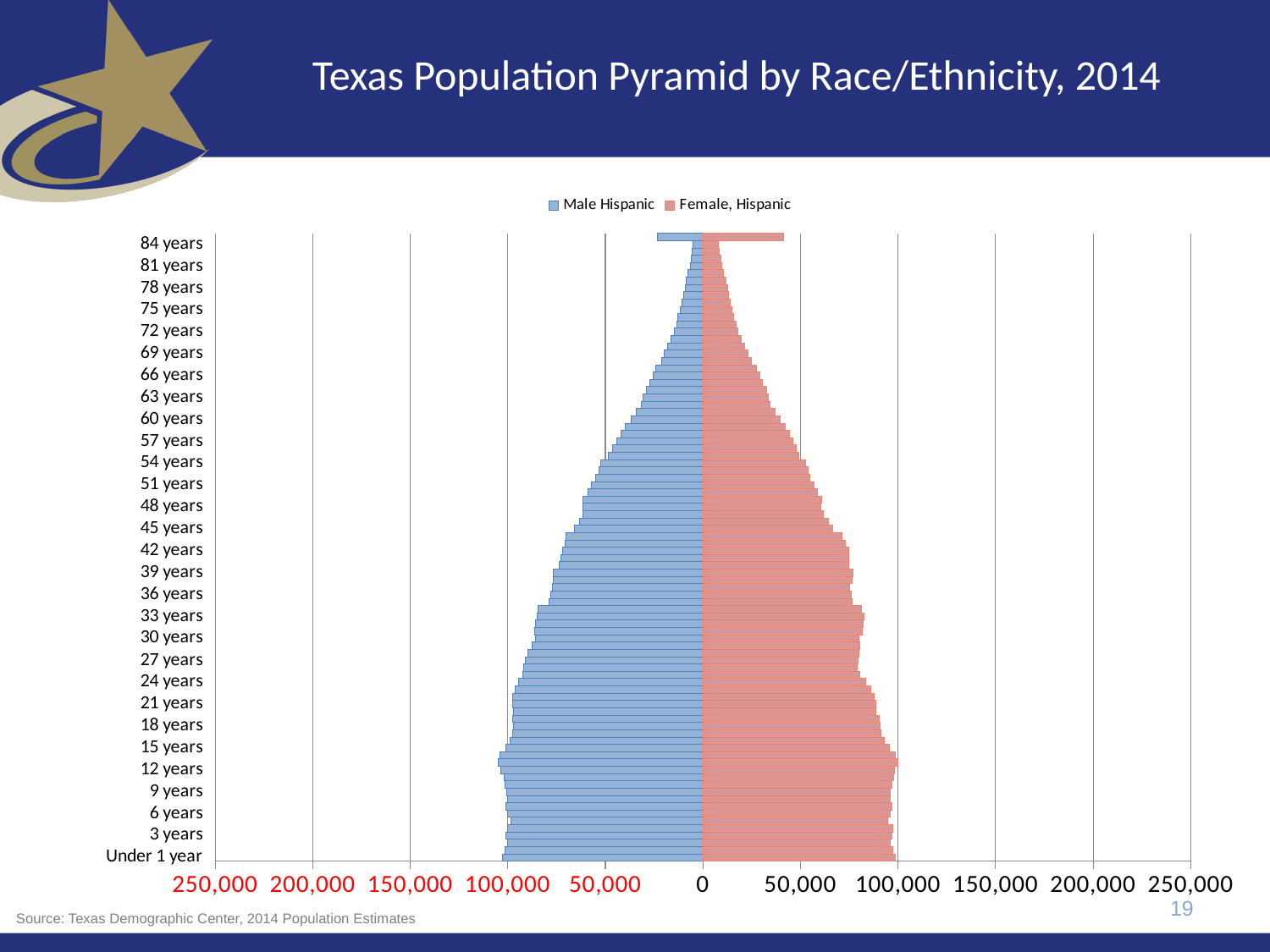
How many series does the legend list? 2 Do the Male Hispanic values generally rise or fall as age increases from Under 1 year to 84 years? fall Is the Male Hispanic value for 45 years greater or less than 100,000? less Is the Female, Hispanic value for 30 years greater or less than 50,000? greater What kind of chart is shown on the slide? bar chart Is the Female, Hispanic value for 72 years greater or less than 50,000? less At 84 years, which is larger, the Male Hispanic value or the Female, Hispanic value? Female, Hispanic What is the title of the chart? Texas Population Pyramid by Race/Ethnicity, 2014 Which series is shown in blue? Male Hispanic